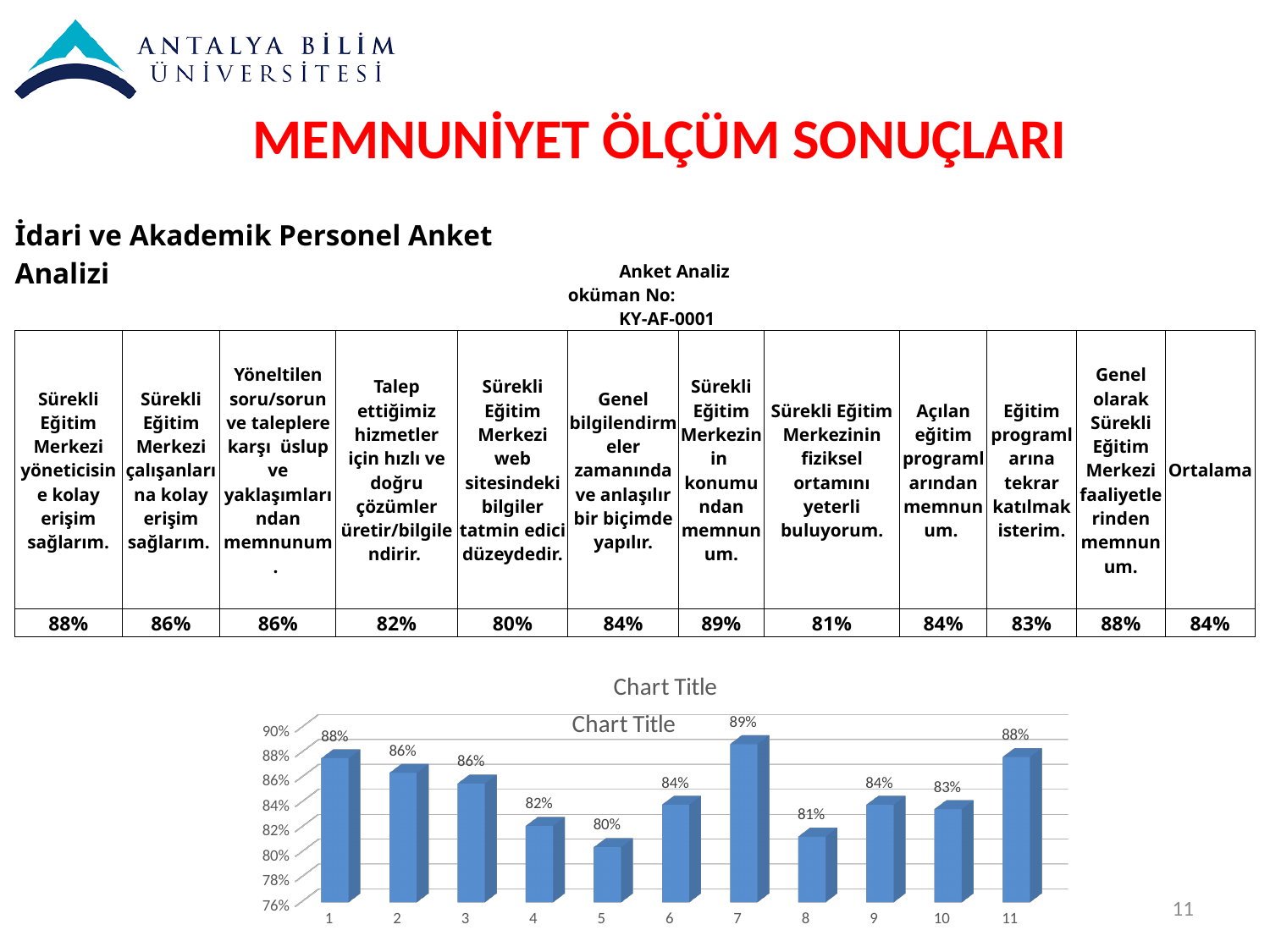
What is the difference between the values for category 1 and category 4? 6% What is the title of the chart? Chart Title What is the value for category 5 in the chart? 80% Which category has the highest value in the chart? 7 What is the value for category 7 in the chart? 89% What is the difference between the values for category 7 and category 5? 9% How many bars are plotted in the chart? 11 Which category has the lowest value in the chart? 5 Which is larger, the value for category 2 or the value for category 8? category 2 What kind of chart is shown on the slide? bar chart What is the value for category 10 in the chart? 83% Is the value for category 11 greater or less than 86%? greater